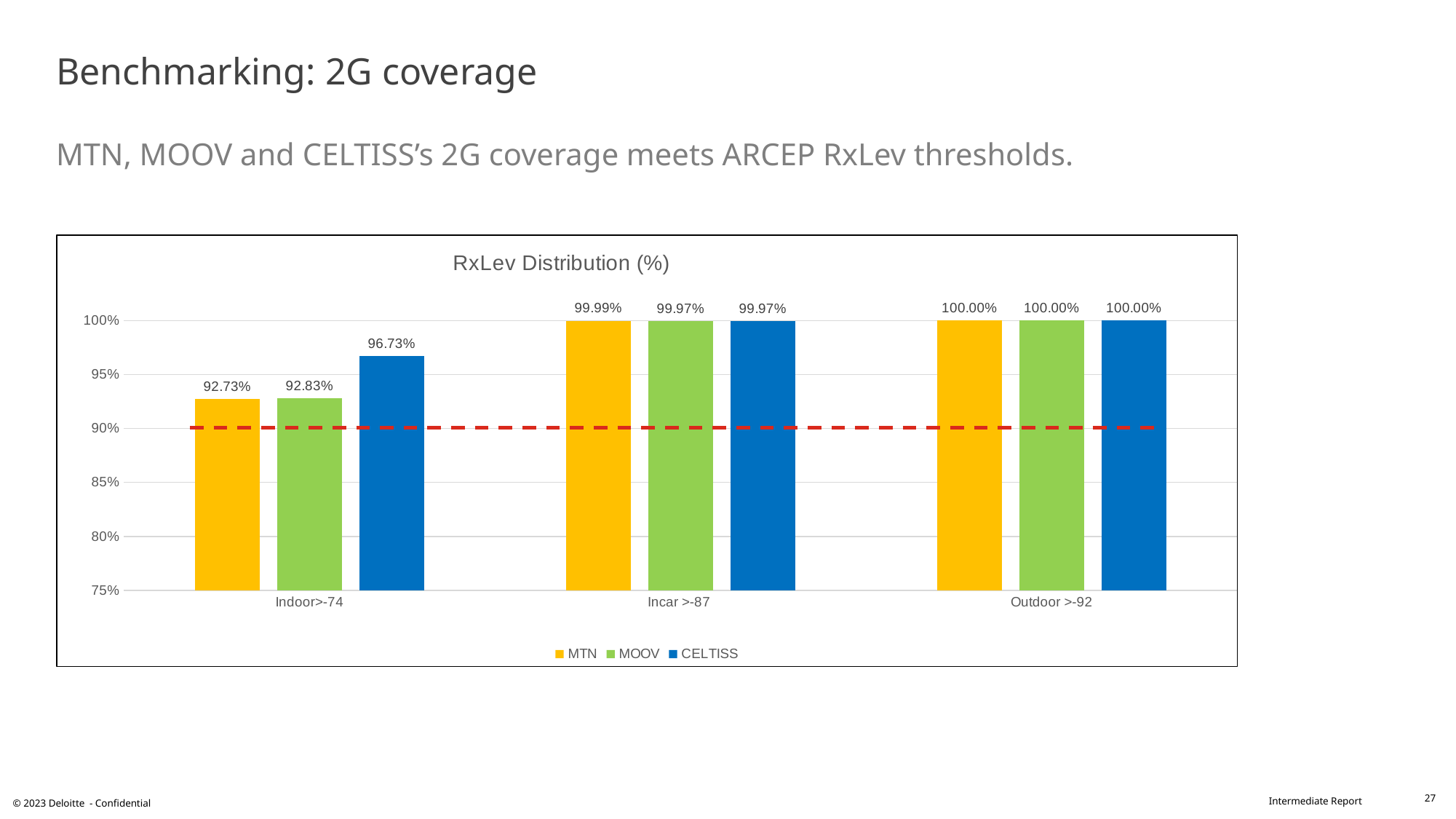
What kind of chart is shown on the slide? Bar chart Which series has the lowest value in the Indoor>-74 category? MTN What is the value for MOOV in the Indoor>-74 category? 92.83% What is the title of the chart? RxLev Distribution (%) How many categories are shown on the x axis? 3 What is the difference between the CELTISS and MTN values in the Indoor>-74 category? 4.00% Do the MTN values rise or fall from Indoor>-74 to Outdoor >-92? Rise What is the value for CELTISS in the Indoor>-74 category? 96.73% Which series has the highest value in the Indoor>-74 category? CELTISS Is the MTN value in the Indoor>-74 category greater or less than 95%? less What is the value for MTN in the Incar >-87 category? 99.99% How many series does the legend list? 3